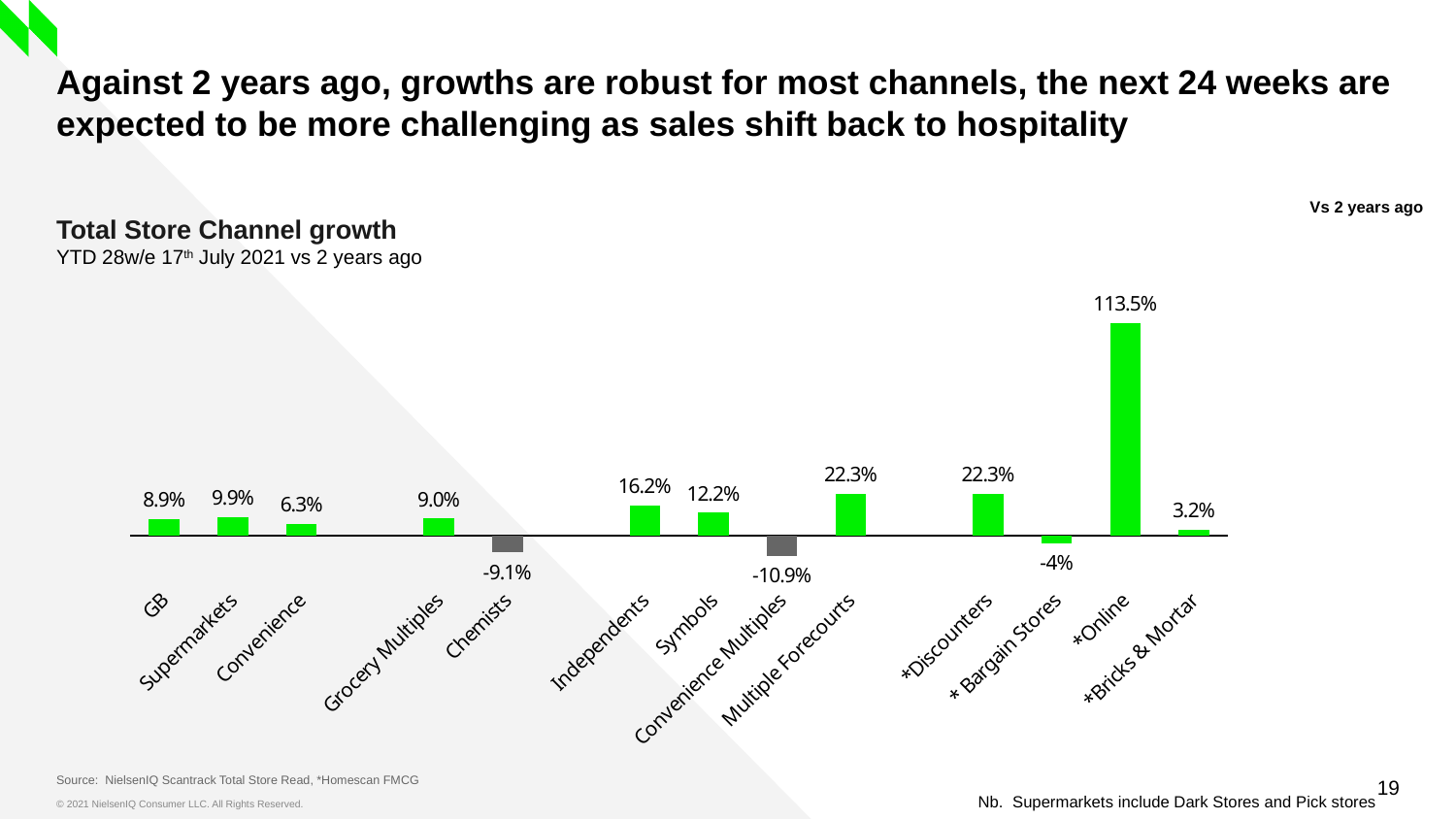
What kind of chart is shown on the slide? Bar chart What is the title of the chart? Total Store Channel growth What is the difference between the growth for *Online and the growth for *Discounters? 91.2% What is the growth value shown for * Bargain Stores? -4% Which channel has the lowest growth in the chart? Convenience Multiples What is the difference between the growth for Independents and the growth for Symbols? 4.0% What is the growth value shown for *Online? 113.5% How many channels are plotted in the chart? 13 Which channel has the highest growth in the chart? *Online Which has the larger growth, Supermarkets or Convenience? Supermarkets What is the growth value shown for Multiple Forecourts? 22.3% What is the growth value shown for Chemists? -9.1%